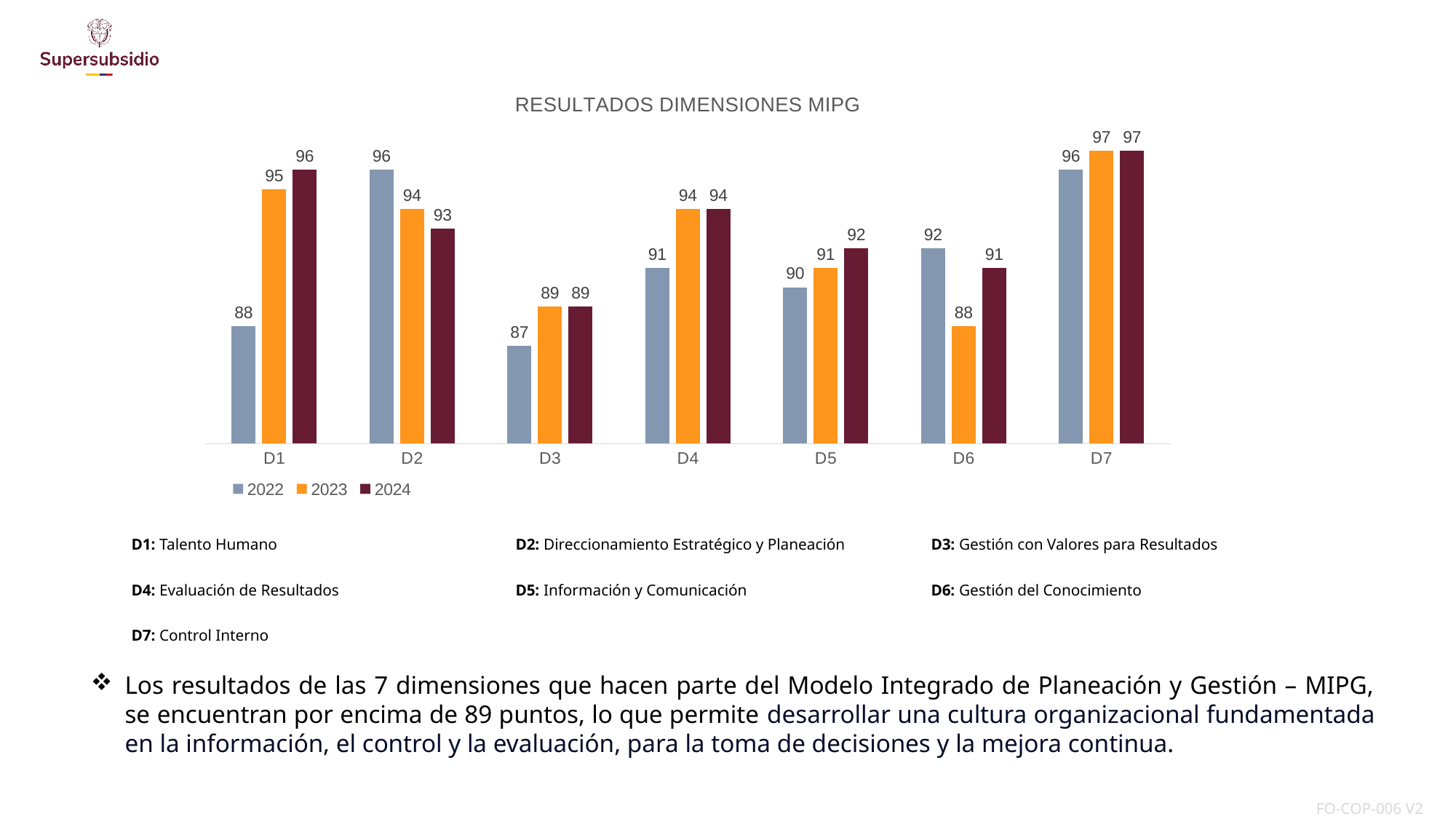
How many series does the legend list? 3 What is the value for D7 in 2024? 97 What kind of chart is shown on the slide? Bar chart What is the title of the chart? RESULTADOS DIMENSIONES MIPG What is the value for D6 in 2023? 88 What is the value for D1 in 2022? 88 Which dimension has the lowest value in the 2022 series? D3 How many dimensions (categories) are shown on the x axis? 7 Which is larger for D2: the 2022 value or the 2024 value? 2022 Which dimension has the highest value in the 2024 series? D7 Which series is shown in orange in the legend? 2023 What is the difference between the 2024 and 2022 values for D1? 8